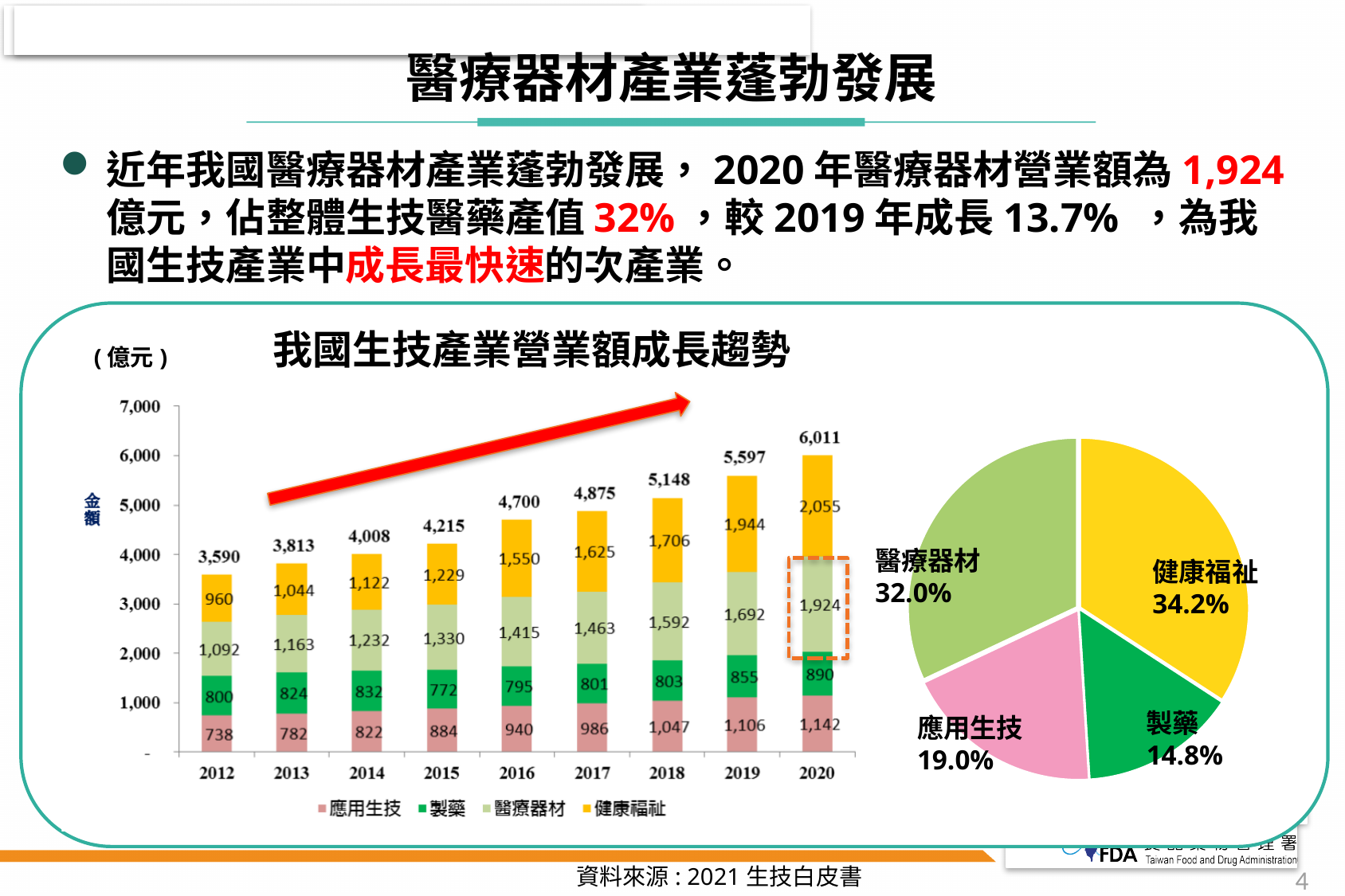
In the bar chart titled 我國生技產業營業額成長趨勢, how many years are shown on the x axis? 9 In the bar chart titled 我國生技產業營業額成長趨勢, how many series does the legend list? 4 What kind of chart is the chart on the right side of the slide? pie chart In the bar chart titled 我國生技產業營業額成長趨勢, do the total values rise or fall from 2012 to 2020? rise In the bar chart titled 我國生技產業營業額成長趨勢, what is the value for 應用生技 in 2012? 738 In the pie chart on the right, which slice is the largest? 健康福祉 In the bar chart titled 我國生技產業營業額成長趨勢, what is the difference between the 健康福祉 values for 2020 and 2019? 111 In the bar chart titled 我國生技產業營業額成長趨勢, what is the value for 醫療器材 in 2020? 1,924 In the bar chart titled 我國生技產業營業額成長趨勢, which is larger in 2015: 製藥 or 應用生技? 應用生技 In the bar chart titled 我國生技產業營業額成長趨勢, which year has the highest total? 2020 In the pie chart on the right, what share does 製藥 have? 14.8% In the bar chart titled 我國生技產業營業額成長趨勢, what is the total of the stacked bar for 2016? 4,700